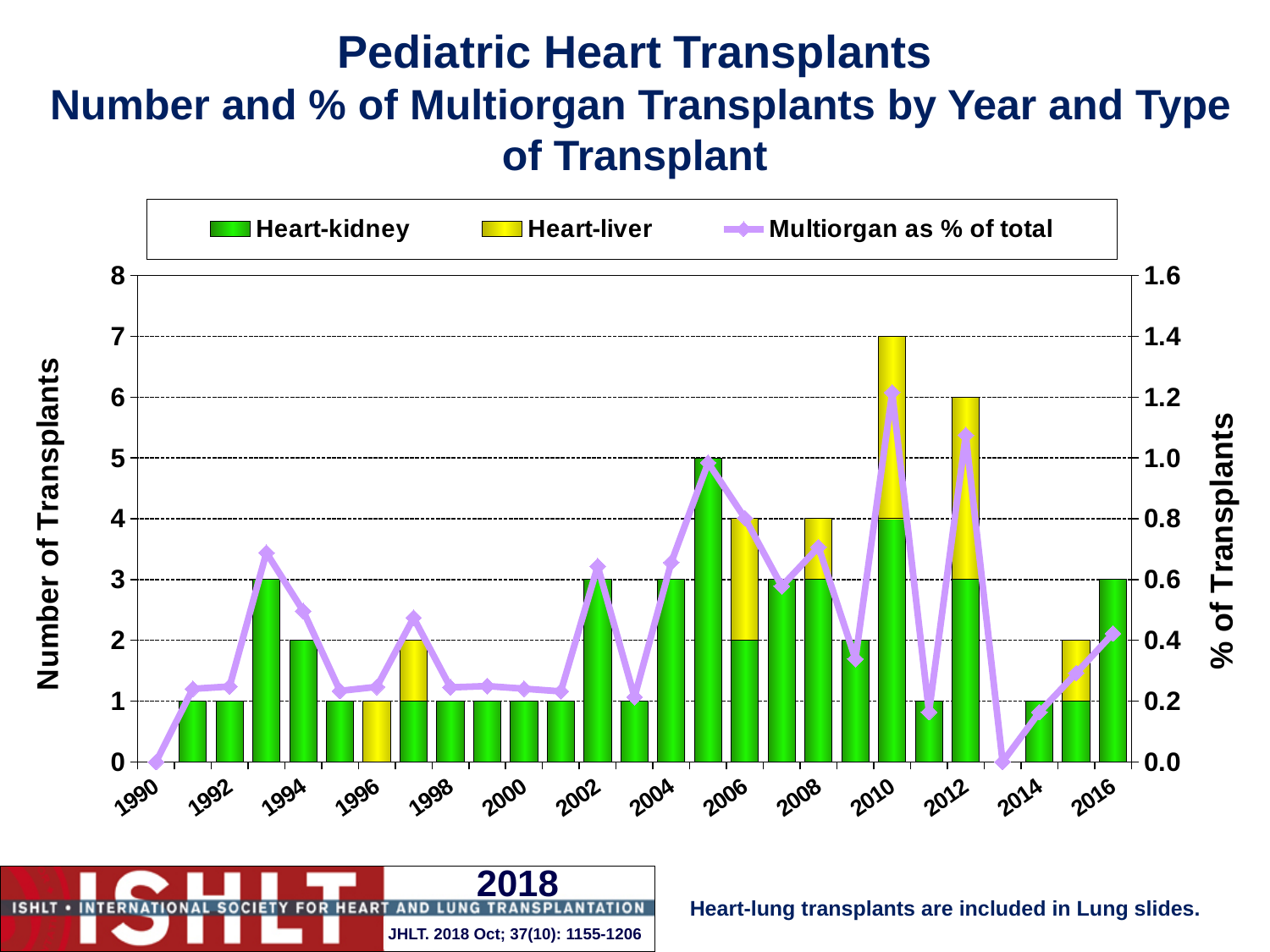
In which year is the total number of multiorgan transplants highest? 2010 How many Heart-liver transplants were there in 2010? 3 Which year had more Heart-kidney transplants, 2005 or 2012? 2005 How many Heart-liver transplants were there in 1996? 1 What is the total number of transplants (Heart-kidney plus Heart-liver) in 2012? 6 How many Heart-kidney transplants were there in 2005? 5 How many series does the legend list? 3 What kind of chart is shown on the slide? A bar chart with a line What is the difference between the total number of transplants in 2010 and in 2012? 1 What colour represents Heart-liver in the legend? Yellow Is the Multiorgan as % of total value for 2010 greater or less than 1.0? greater